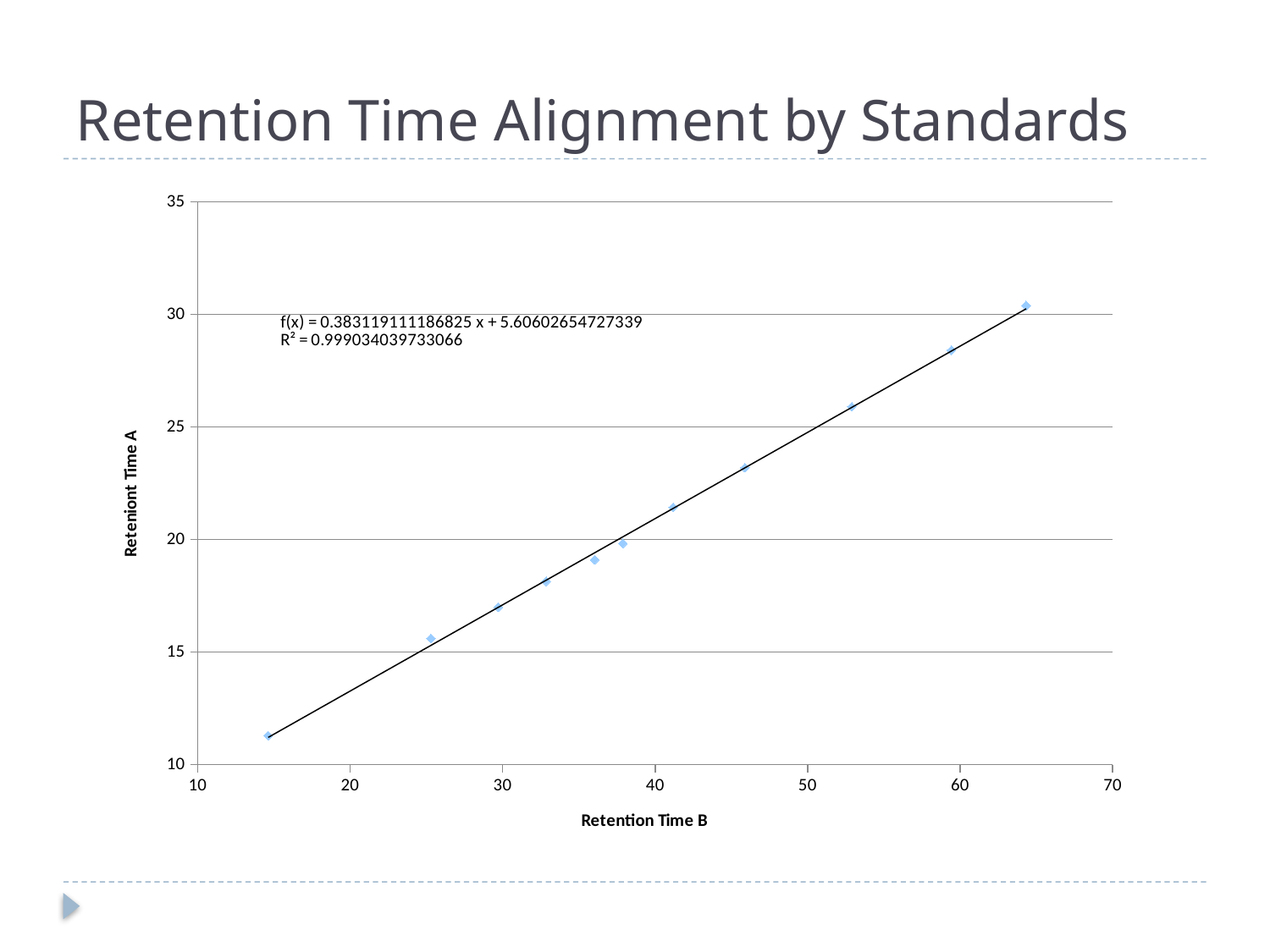
What kind of chart is shown on the slide? Scatter chart Is the Retention Time A value for the point near Retention Time B of 53 greater or less than 25? greater Is the Retention Time A value for the point near Retention Time B of 46 greater or less than 25? less What is the R² value printed on the chart? 0.999034039733066 Is the Retention Time A value for the point with the lowest Retention Time B greater or less than 15? less Do the values of Retention Time A rise or fall as Retention Time B increases? Rise What is the title of the slide containing the chart? Retention Time Alignment by Standards What is the label of the x axis? Retention Time B How many data points are plotted on the chart? 11 Which point has the higher Retention Time A: the one near Retention Time B of 25 or the one near Retention Time B of 59? The one near Retention Time B of 59 What is the slope of the fitted line f(x) printed on the chart? 0.383119111186825